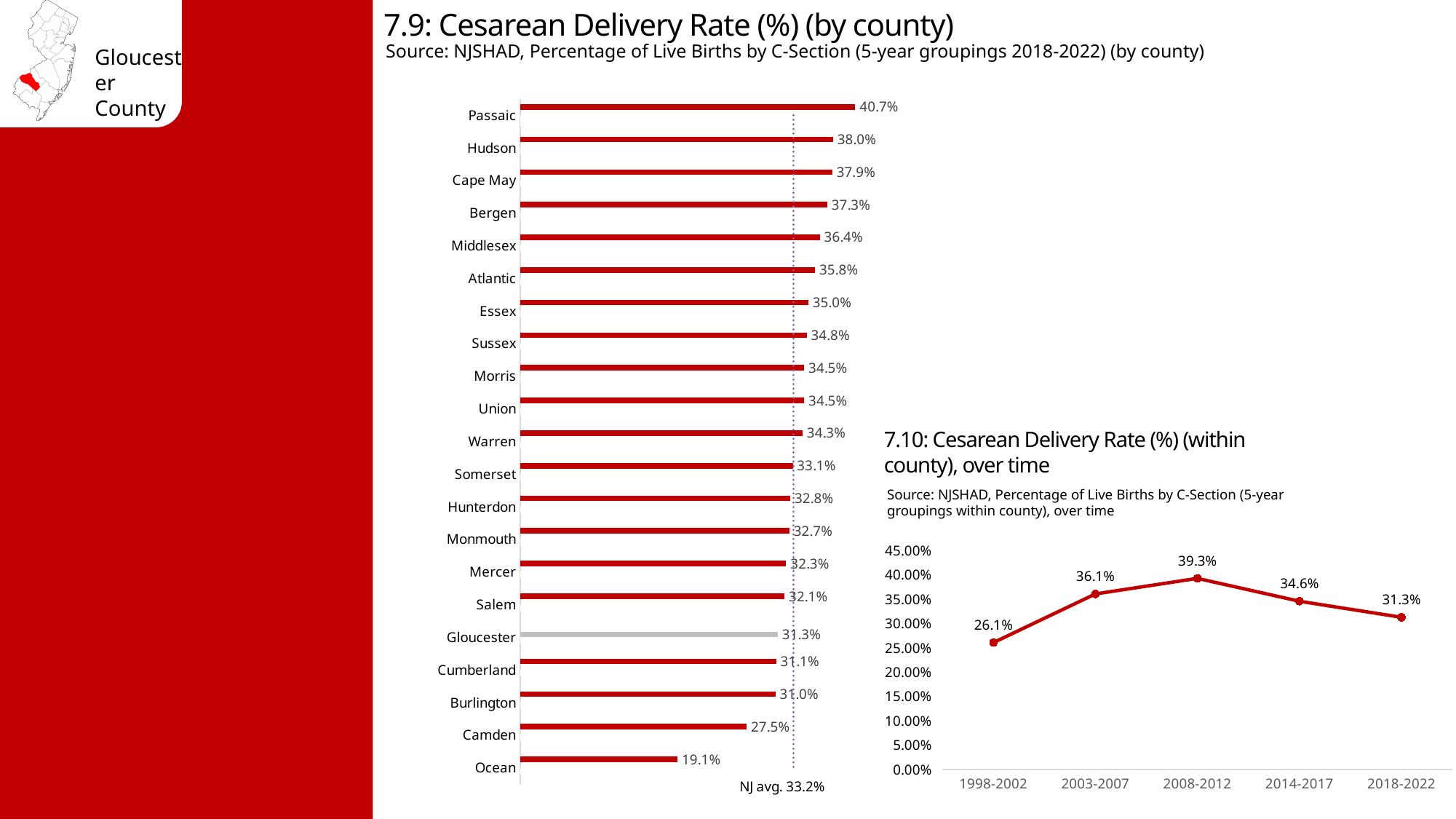
In the 7.9 bar chart (by county), which county has the highest cesarean delivery rate? Passaic In the 7.9 bar chart (by county), which county has the lowest cesarean delivery rate? Ocean In the 7.9 bar chart (by county), what is the cesarean delivery rate for Gloucester? 31.3% In the 7.9 bar chart (by county), which county has a higher rate, Camden or Burlington? Burlington In the 7.10 line chart (within county, over time), does the rate rise or fall from 2008-2012 to 2018-2022? Fall In the 7.10 line chart (within county, over time), which period has the lowest rate? 1998-2002 In the 7.10 line chart (within county, over time), what is the cesarean delivery rate for 2008-2012? 39.3% In the 7.9 bar chart (by county), what is the NJ average rate shown by the dotted line? 33.2% In the 7.9 bar chart (by county), what is the difference between the rates for Passaic and Ocean? 21.6% In the 7.10 line chart (within county, over time), how many time periods are plotted? 5 In the 7.9 bar chart (by county), how many counties are shown? 21 What kind of chart is 7.10 (within county, over time)? Line chart